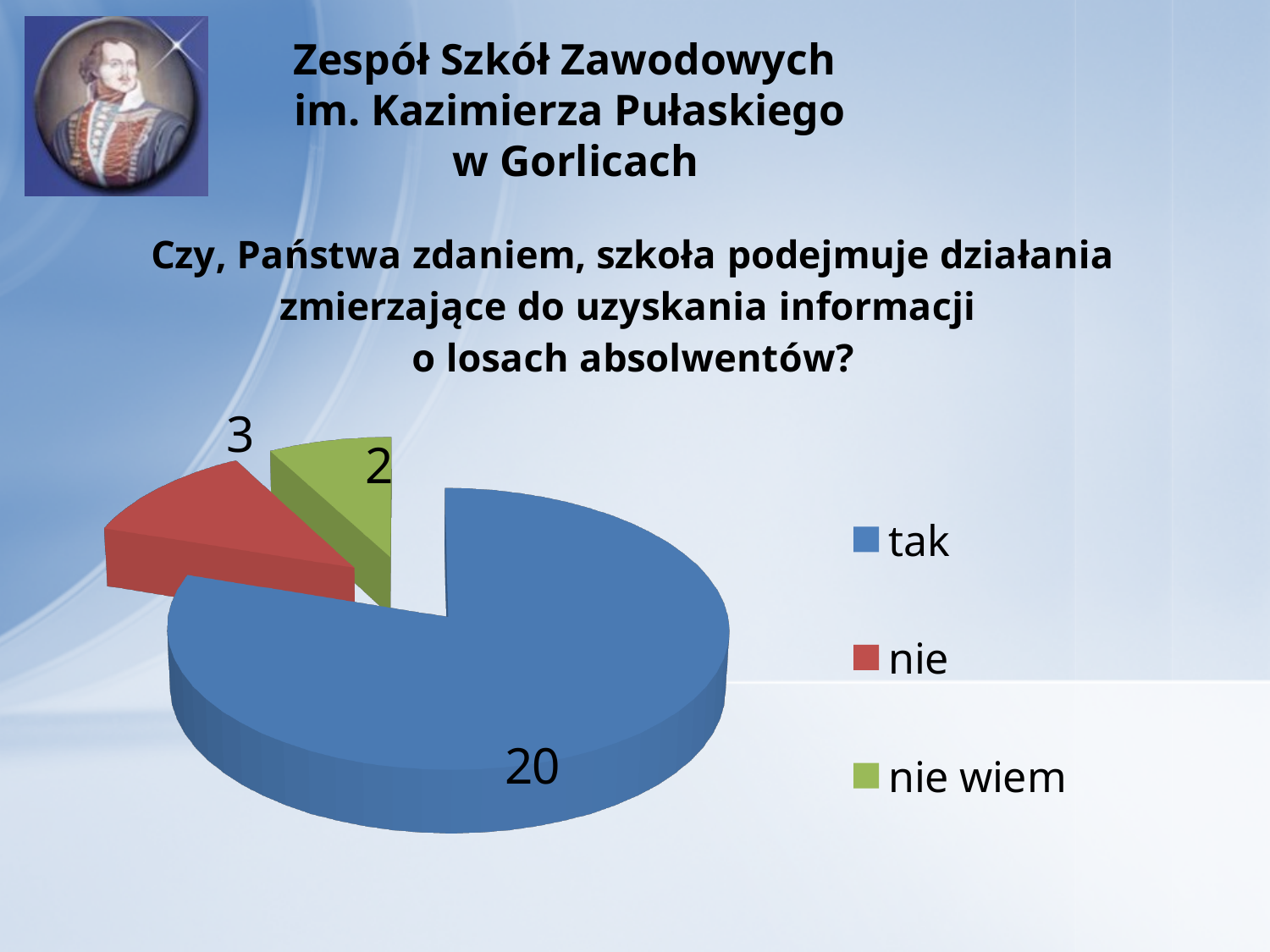
What is the value for "nie"? 3 How many categories does the pie chart have? 3 What kind of chart is shown on the slide? pie chart What share of the pie does "tak" represent? 80% What is the value for "nie wiem"? 2 Which category has the smallest slice? nie wiem What is the difference between the values for "tak" and "nie"? 17 What is the value for "tak"? 20 Which category has the largest slice? tak What is the total of all slices in the pie chart? 25 Which is larger, the value for "nie" or the value for "nie wiem"? nie What colour is the slice for "nie"? red